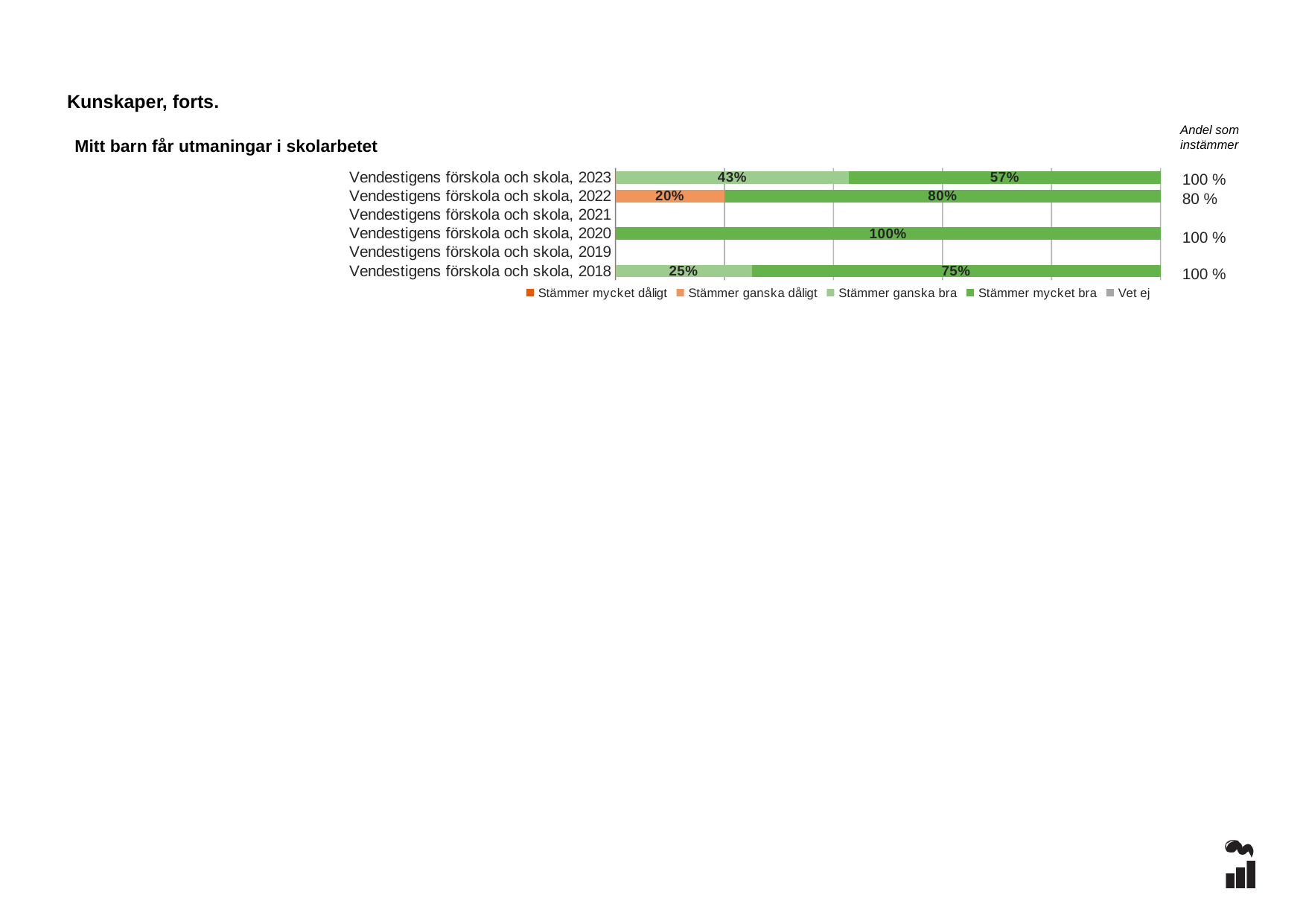
Which year has the highest value for "Stämmer mycket bra"? 2020 What is the value for "Stämmer ganska bra" for Vendestigens förskola och skola, 2023? 43% What is the "Andel som instämmer" value shown for Vendestigens förskola och skola, 2022? 80 % What is the value for "Stämmer ganska bra" for Vendestigens förskola och skola, 2018? 25% What is the difference between the "Stämmer mycket bra" values for 2022 and 2023? 23% What is the value for "Stämmer ganska dåligt" for Vendestigens förskola och skola, 2022? 20% Which is larger: the "Stämmer mycket bra" value for 2018 or for 2023? 2018 How many series does the legend list? 5 How many categories are listed on the vertical axis? 6 What kind of chart is shown on the slide? Stacked bar chart What is the value for "Stämmer mycket bra" for Vendestigens förskola och skola, 2020? 100% What is the value for "Stämmer mycket bra" for Vendestigens förskola och skola, 2023? 57%